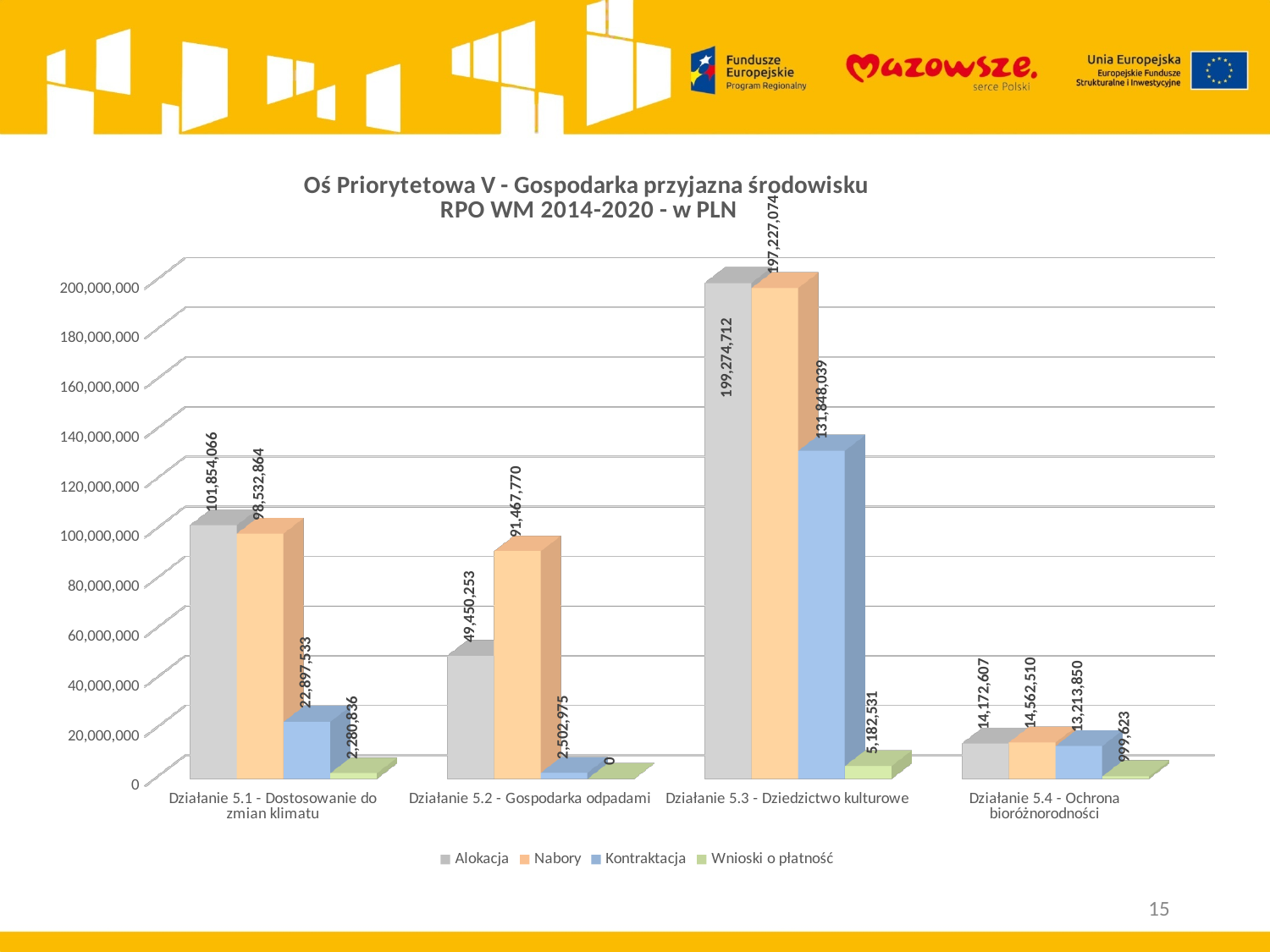
Which category has the highest Alokacja value? Działanie 5.3 - Dziedzictwo kulturowe What is the Alokacja value for Działanie 5.3 - Dziedzictwo kulturowe? 199,274,712 What kind of chart is shown on the slide? Bar chart What is the Wnioski o płatność value for Działanie 5.4 - Ochrona bioróżnorodności? 999,623 How many series does the legend list? 4 Which category has the lowest Nabory value? Działanie 5.4 - Ochrona bioróżnorodności For Działanie 5.2 - Gospodarka odpadami, which is larger: Alokacja or Nabory? Nabory What is the difference between the Alokacja and Nabory values for Działanie 5.1 - Dostosowanie do zmian klimatu? 3,321,202 What is the Kontraktacja value for Działanie 5.1 - Dostosowanie do zmian klimatu? 22,897,533 What is the Nabory value for Działanie 5.2 - Gospodarka odpadami? 91,467,770 What is the difference between the Alokacja and Kontraktacja values for Działanie 5.3 - Dziedzictwo kulturowe? 67,426,673 How many categories (Działania) are shown on the x axis? 4